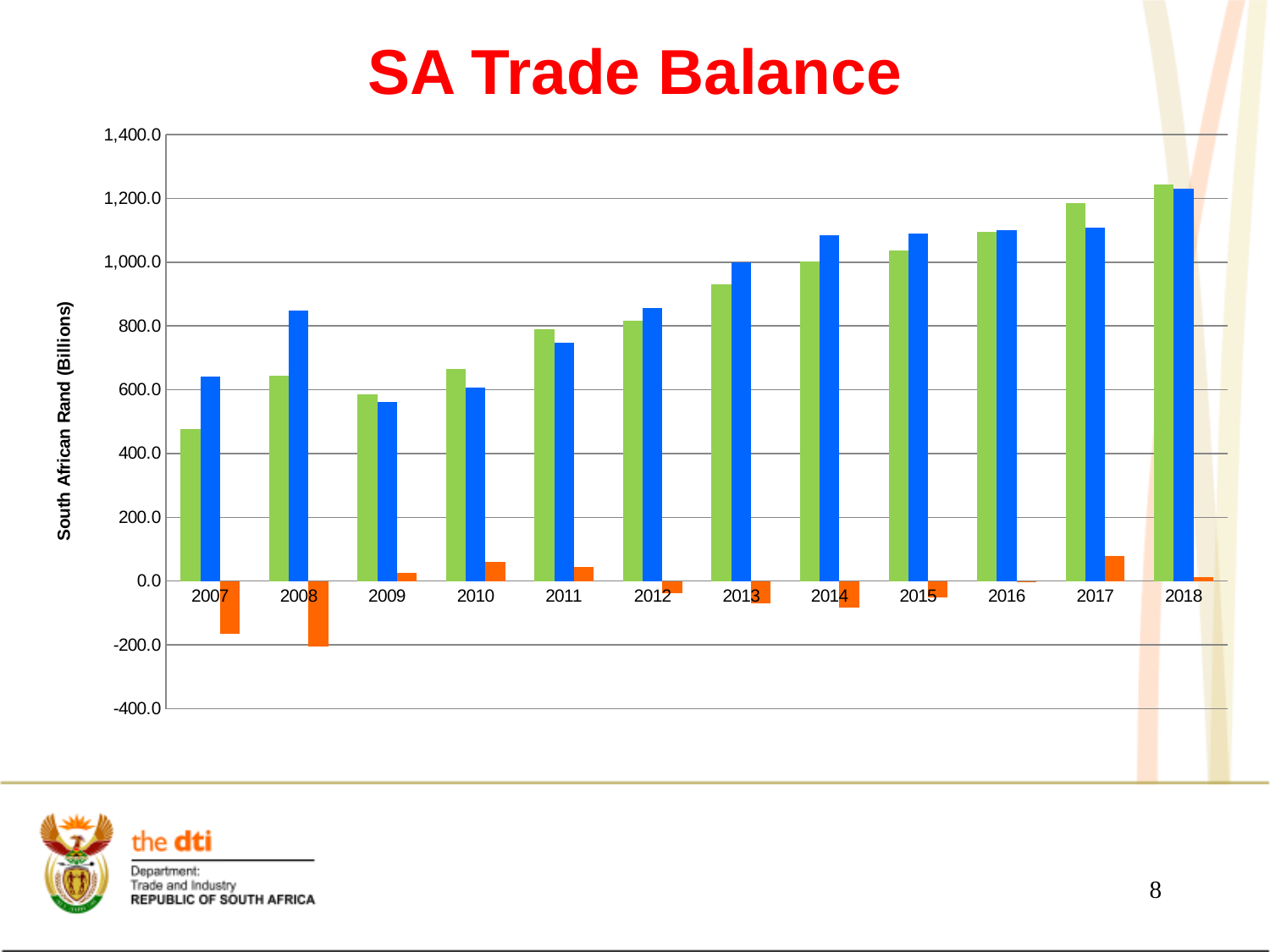
In 2011, which is larger, the green bar or the blue bar? the green bar What is the title of the chart? SA Trade Balance What kind of chart is shown on the slide? bar chart In which year is the orange bar the lowest (most negative)? 2008 Is the value of the green bar for 2013 greater or less than 1,000.0? less Is the value of the green bar for 2007 greater or less than 600.0? less How many years are shown along the x axis of the chart? 12 In which year is the green bar the highest? 2018 In which year is the green bar the lowest? 2007 In 2008, which is larger, the green bar or the blue bar? the blue bar Is the value of the blue bar for 2008 greater or less than 800.0? greater What is the label on the vertical axis of the chart? South African Rand (Billions)